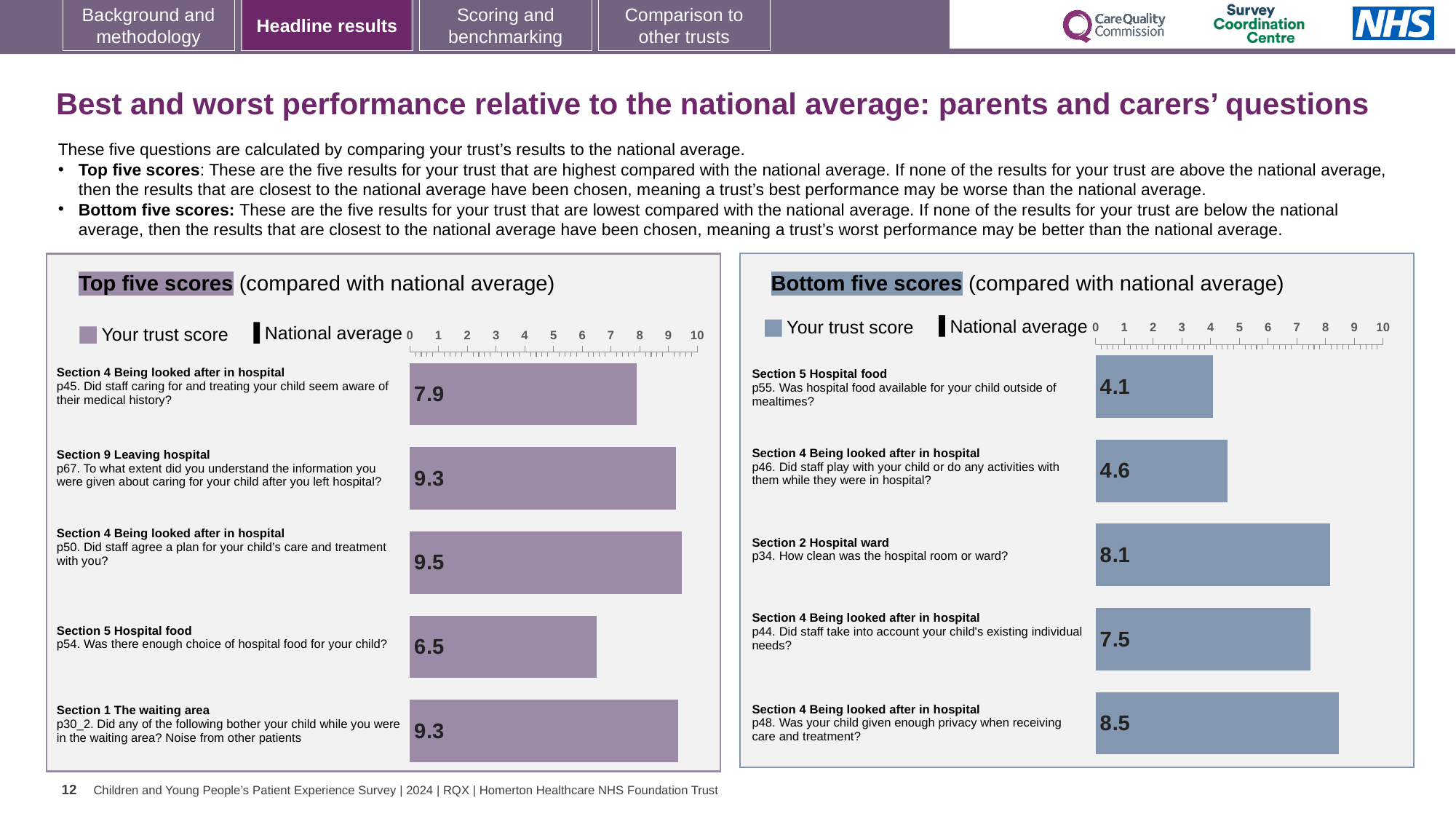
In the Bottom five scores chart, what is the trust score for p34 (How clean was the hospital room or ward)? 8.1 How many questions are plotted in the Bottom five scores chart? 5 In the Top five scores chart, what is the difference between the trust scores for p50 and p54? 3.0 In the Bottom five scores chart, which has the larger trust score: p46 or p44? p44 What kind of chart is the Top five scores chart? Bar chart In the Top five scores chart, what is the trust score for p45 (Did staff caring for and treating your child seem aware of their medical history)? 7.9 In the Bottom five scores chart, which question has the lowest trust score? p55. Was hospital food available for your child outside of mealtimes? In the Top five scores chart, which question has the lowest trust score? p54. Was there enough choice of hospital food for your child? In the Top five scores chart, which question has the highest trust score? p50. Did staff agree a plan for your child's care and treatment with you? In the Bottom five scores chart, which question has the highest trust score? p48. Was your child given enough privacy when receiving care and treatment? In the Top five scores chart, what is the trust score for p54 (Was there enough choice of hospital food for your child)? 6.5 In the Bottom five scores chart, what is the trust score for p55 (Was hospital food available for your child outside of mealtimes)? 4.1